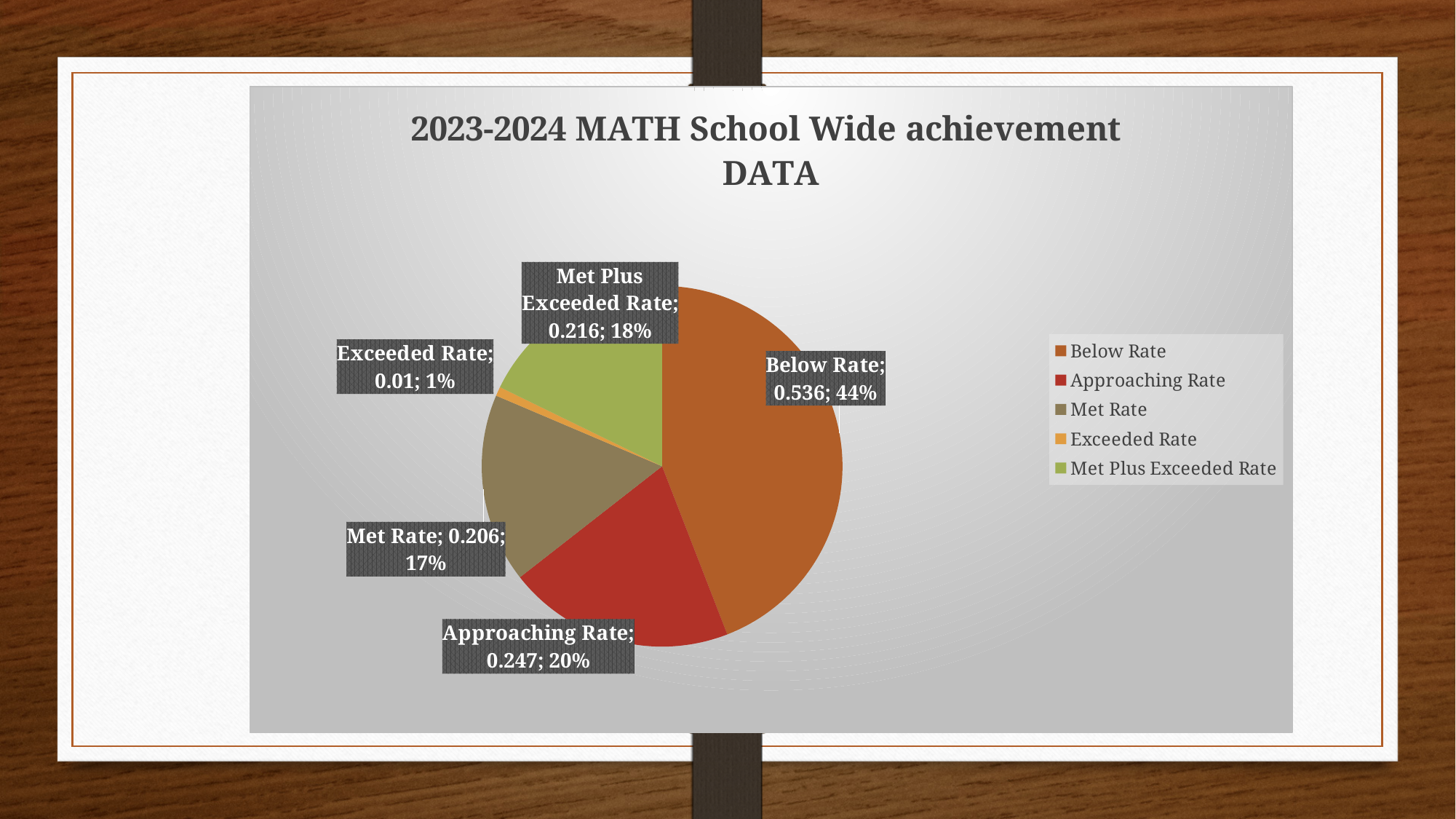
What is the value for Below Rate? 0.536 Which category has the smallest slice? Exceeded Rate How many slices does the pie chart have? 5 What is the value for Approaching Rate? 0.247 Which is larger, Approaching Rate or Met Rate? Approaching Rate What percentage share of the pie does Below Rate have? 44% What percentage share of the pie does Met Plus Exceeded Rate have? 18% What is the value for Met Rate? 0.206 What is the title of the chart? 2023-2024 MATH School Wide achievement DATA What kind of chart is shown on the slide? pie chart What is the value for Exceeded Rate? 0.01 Which category has the largest slice? Below Rate